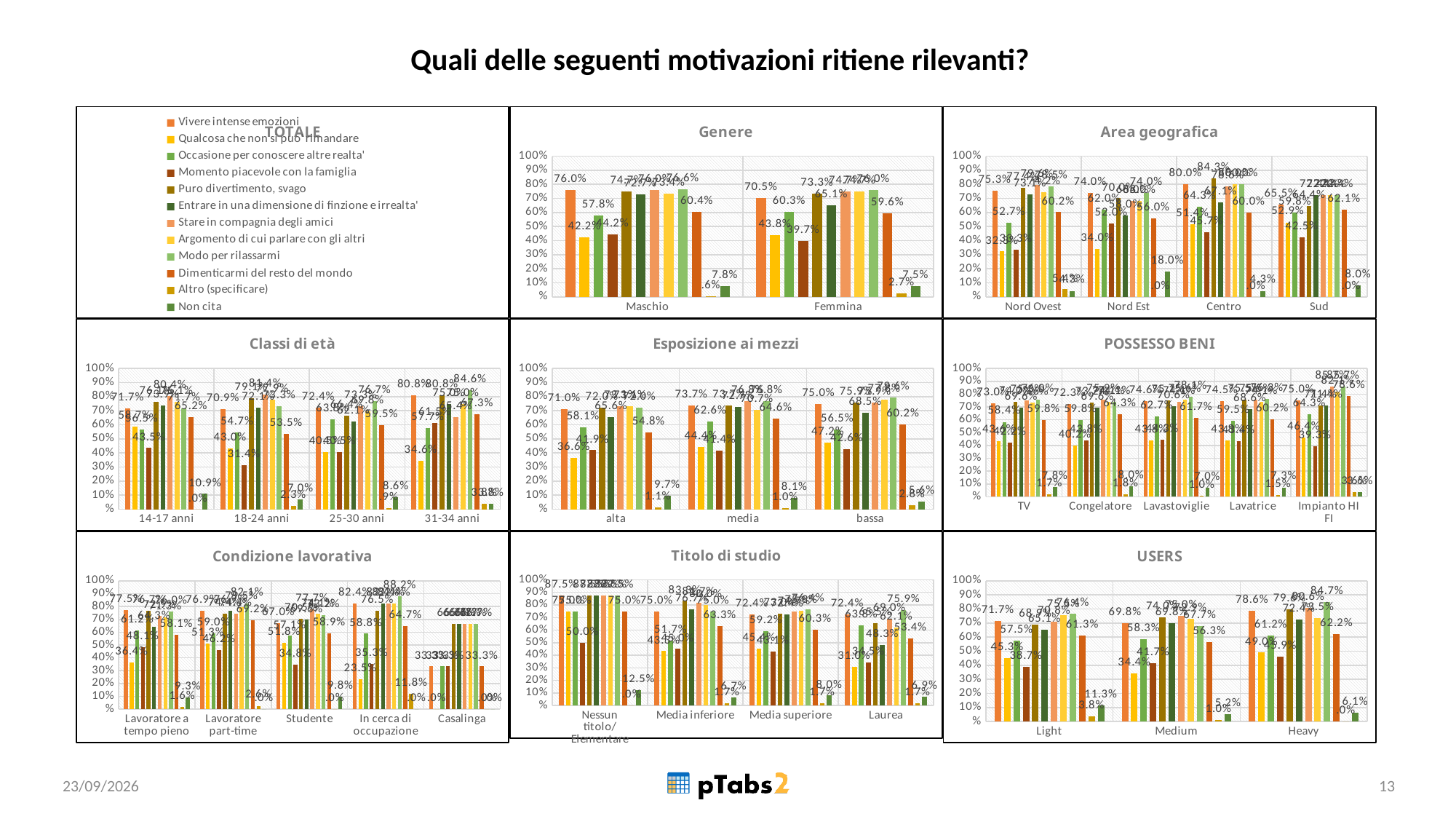
In the Titolo di studio chart, what is the 'Non cita' value for 'Nessun titolo/Elementare'? 12.5% What kind of chart is the Genere chart? bar chart In the USERS chart, which user group has the highest 'Non cita' value? Light In the Genere chart, what is the difference between the 'Vivere intense emozioni' values for Maschio and Femmina? 5.5% In the Esposizione ai mezzi chart, is the 'Vivere intense emozioni' value for bassa greater or less than 70%? greater In the Area geografica chart, what is the 'Non cita' value for Nord Est? 18.0% How many series does the legend in the TOTALE panel list? 12 In the Genere chart, what is the value of 'Vivere intense emozioni' for Maschio? 76.0% In the Area geografica chart, which area has the highest 'Non cita' value? Nord Est In the USERS chart, what is the 'Vivere intense emozioni' value for Heavy users? 78.6% In the Genere chart, what is the value of 'Vivere intense emozioni' for Femmina? 70.5% In the Classi di età chart, which age class has the highest 'Non cita' value? 14-17 anni